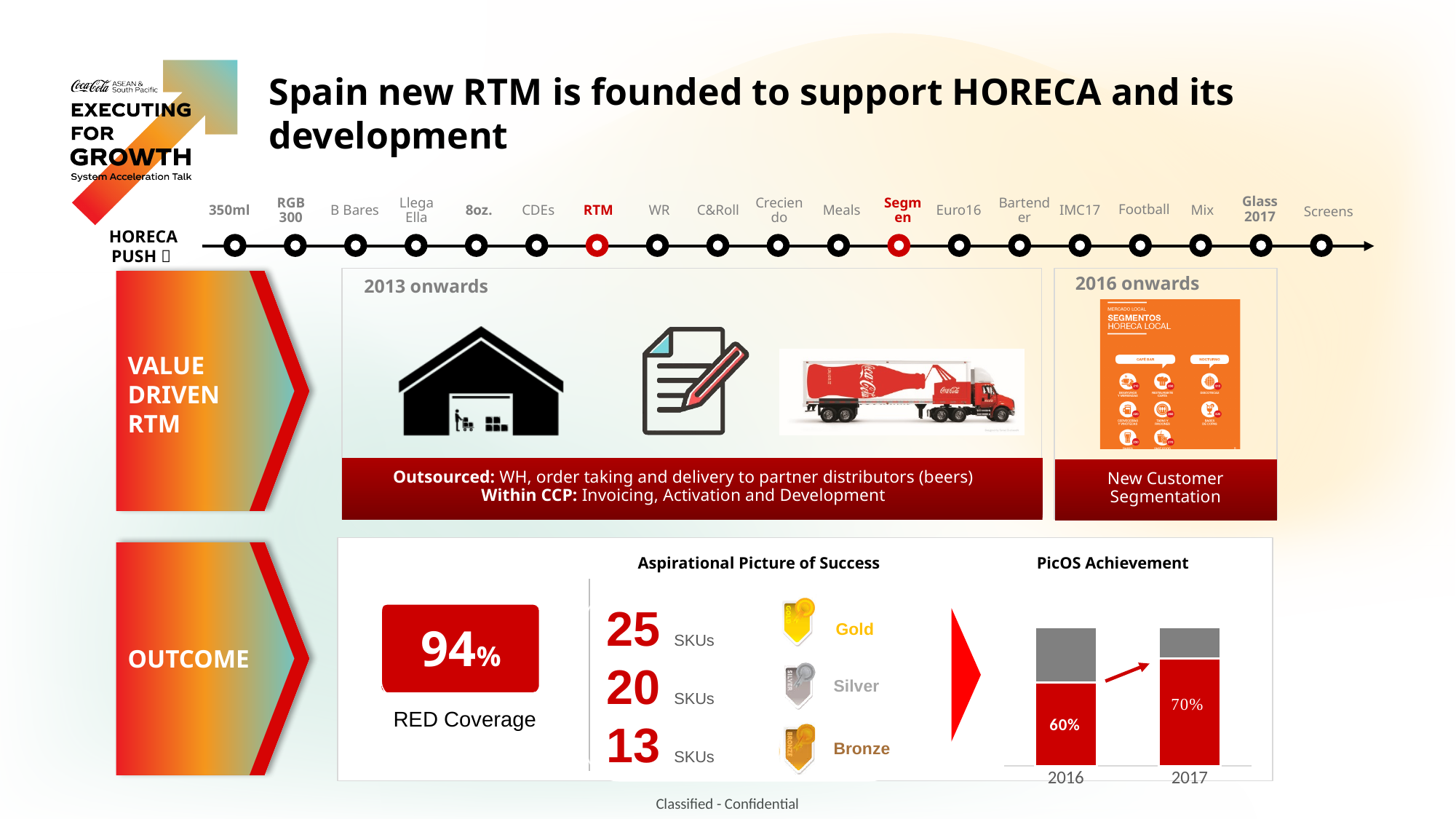
In the PicOS Achievement chart, is the value for 2017 larger or smaller than the value for 2016? larger In the PicOS Achievement chart, does the labelled value rise or fall from 2016 to 2017? rise In the PicOS Achievement chart, which year has the higher labelled value? 2017 In the PicOS Achievement chart, what colour is the labelled (lower) segment of each bar? red In the PicOS Achievement chart, what is the labelled value for 2016? 60% In the PicOS Achievement chart, what is the labelled value for 2017? 70% In the PicOS Achievement chart, which year has the lower labelled value? 2016 How many years are shown on the x axis of the PicOS Achievement chart? 2 What is the title of the chart in the bottom right of the slide? PicOS Achievement What kind of chart is the PicOS Achievement chart? bar chart In the PicOS Achievement chart, by how many percentage points does the 2017 value exceed the 2016 value? 10 percentage points